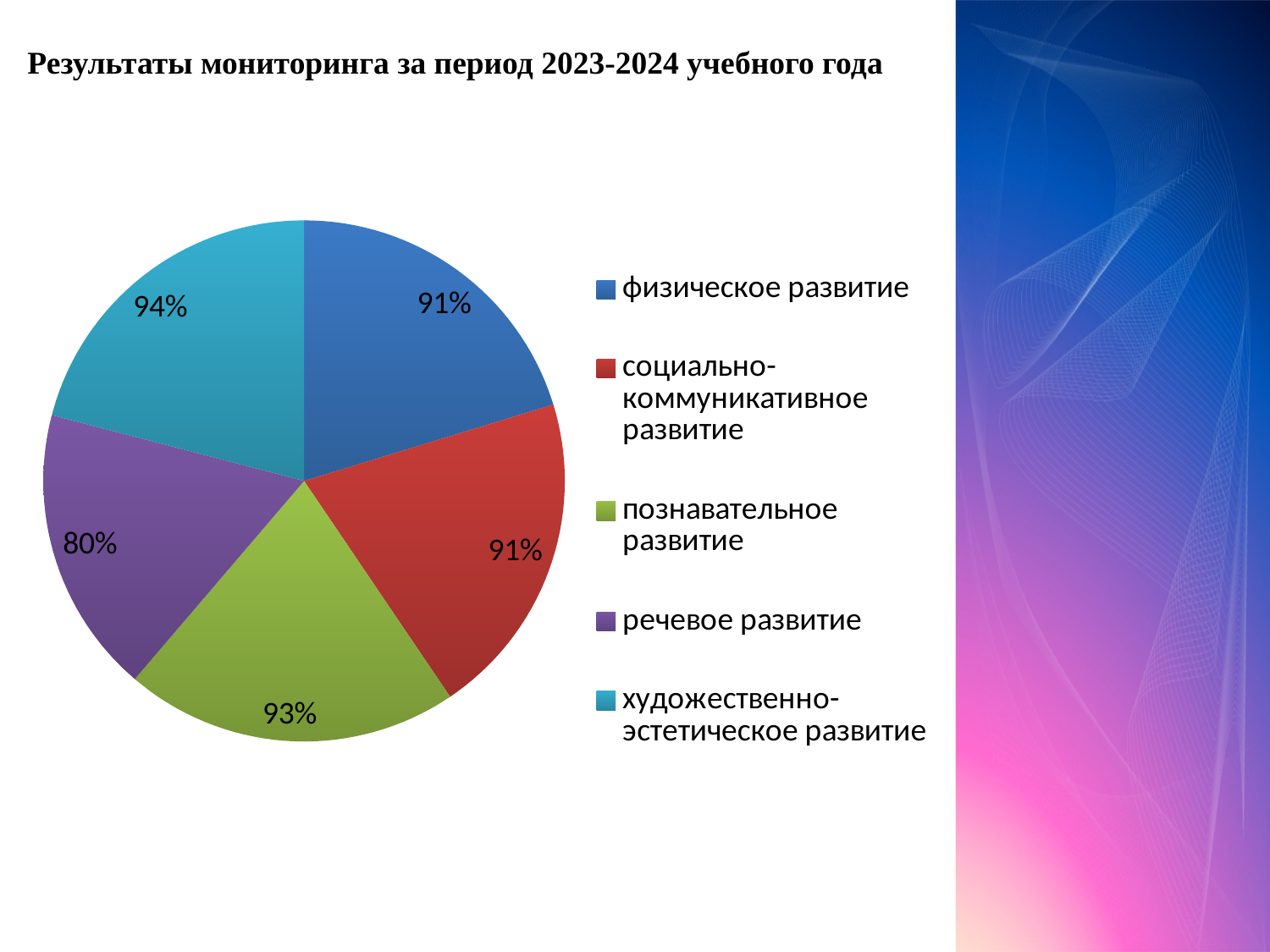
What kind of chart is shown on the slide? pie chart What value is shown for познавательное развитие? 93% Which category has the highest value? художественно-эстетическое развитие What value is shown for художественно-эстетическое развитие? 94% Which is larger, the value for познавательное развитие or the value for речевое развитие? познавательное развитие Which category has the lowest value? речевое развитие What value is shown for социально-коммуникативное развитие? 91% What is the title of the slide? Результаты мониторинга за период 2023-2024 учебного года What is the difference between the values for художественно-эстетическое развитие and речевое развитие? 14 percentage points What value is shown for физическое развитие? 91% What value is shown for речевое развитие? 80% How many categories does the chart show? 5